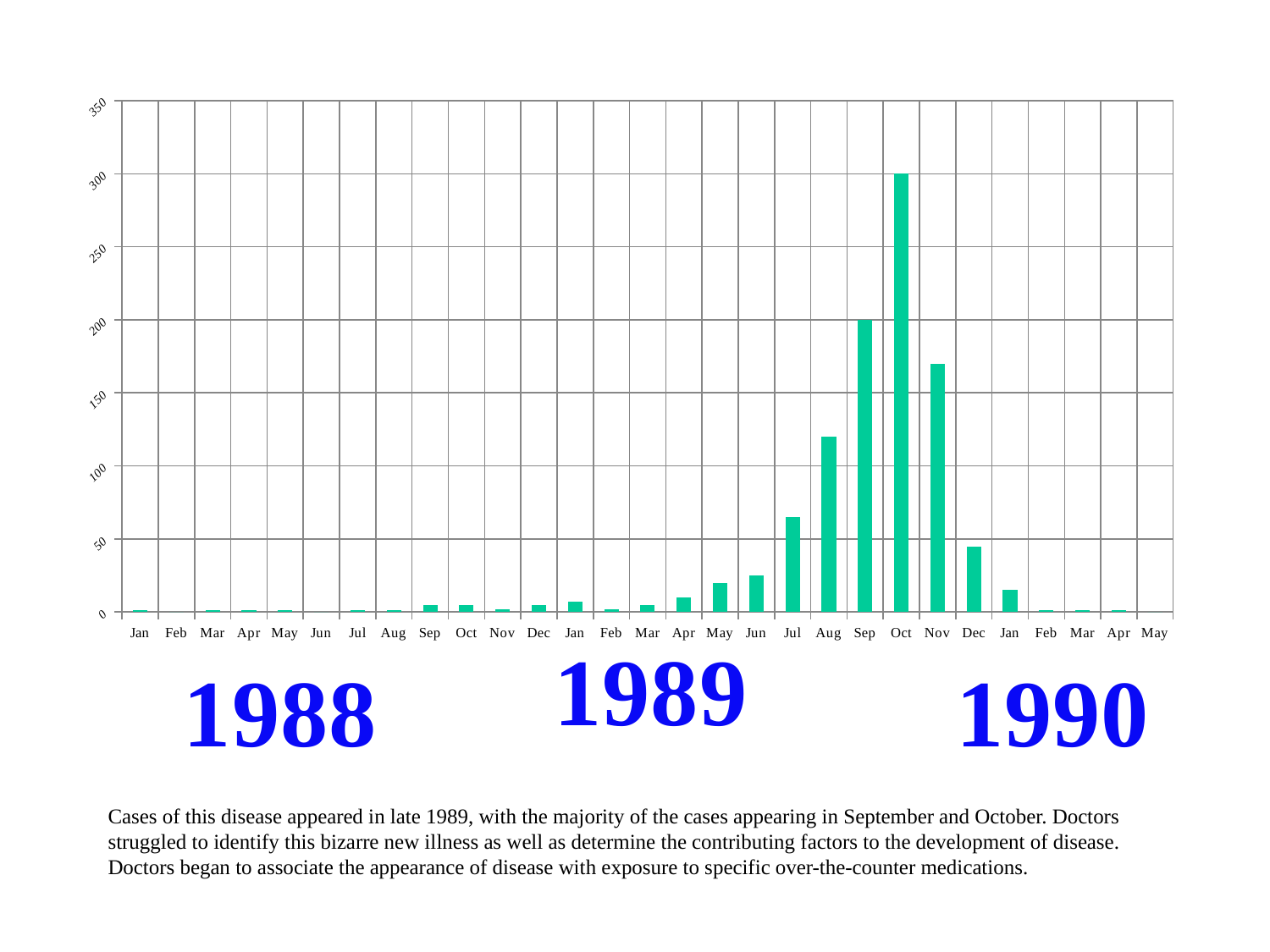
Which is larger, the value for Sep 1989 or the value for Nov 1989? Sep 1989 What is the difference between the values for Oct 1989 and Sep 1989? 100 What is the value for Sep 1989? 200 Is the value for Nov 1989 greater or less than 150? greater Do the values rise or fall from Jul 1989 to Oct 1989? rise Is the value for Jul 1989 greater or less than 50? greater Is the value for Aug 1989 greater or less than 100? greater How many months are shown along the x axis of the chart? 29 What is the value for Oct 1989? 300 Which month has the highest bar on the chart? Oct 1989 What kind of chart is shown on the slide? bar chart